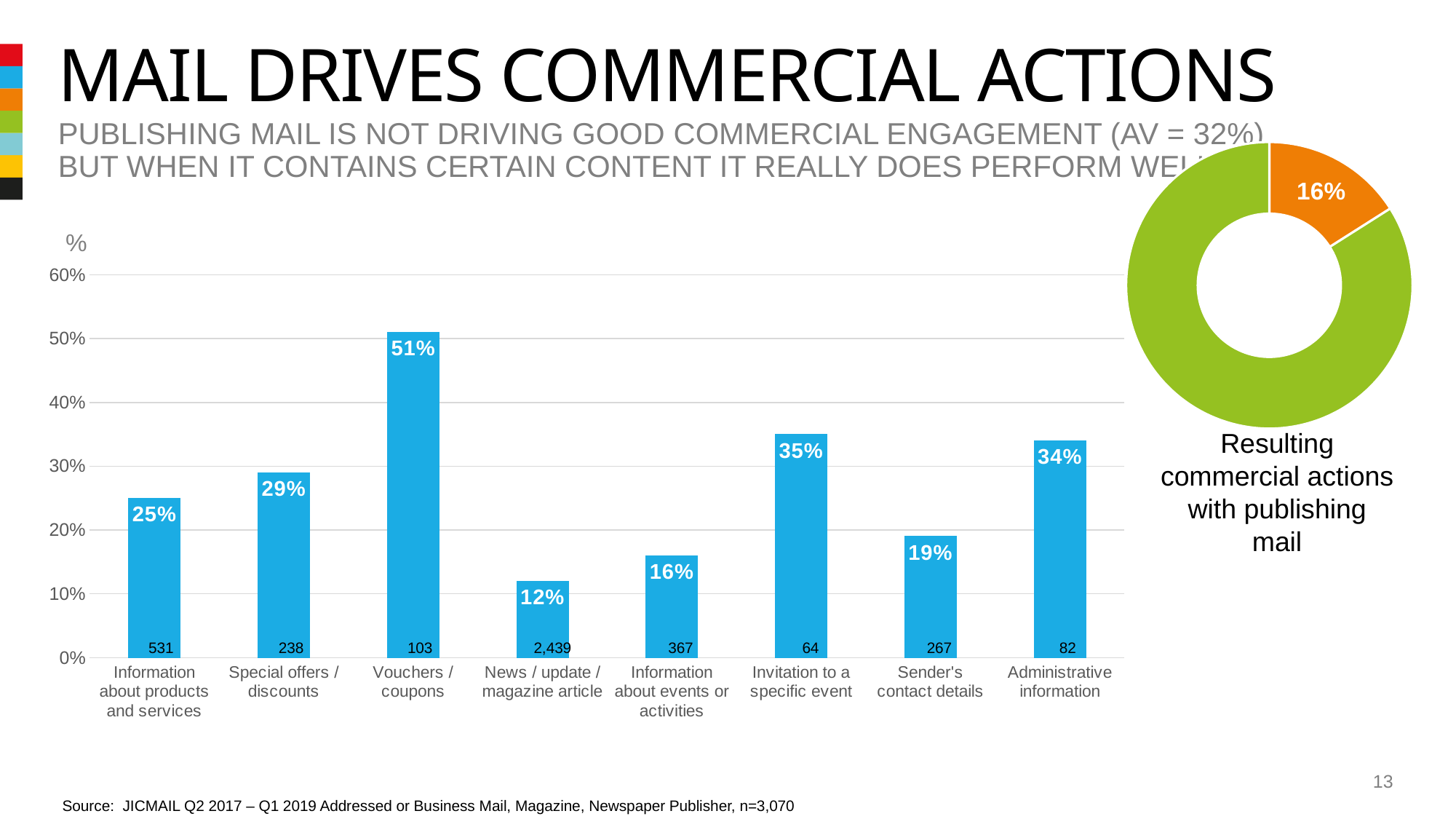
In the bar chart, which is larger: the value for Special offers / discounts or the value for Information about products and services? Special offers / discounts In the chart titled 'Resulting commercial actions with publishing mail', what value is labelled on the orange slice? 16% In the bar chart, what is the value for Vouchers / coupons? 51% In the bar chart, what is the value for Invitation to a specific event? 35% In the bar chart, is the value for Sender's contact details greater or less than 20%? less What kind of chart is the chart on the left of the slide? Bar chart In the bar chart, which category has the lowest value? News / update / magazine article In the bar chart, what is the difference between the values for Vouchers / coupons and News / update / magazine article? 39% What kind of chart is the chart titled 'Resulting commercial actions with publishing mail'? Doughnut (pie) chart In the bar chart, what number is printed at the base of the News / update / magazine article bar? 2,439 In the bar chart, which category has the highest value? Vouchers / coupons How many categories are shown in the bar chart? 8